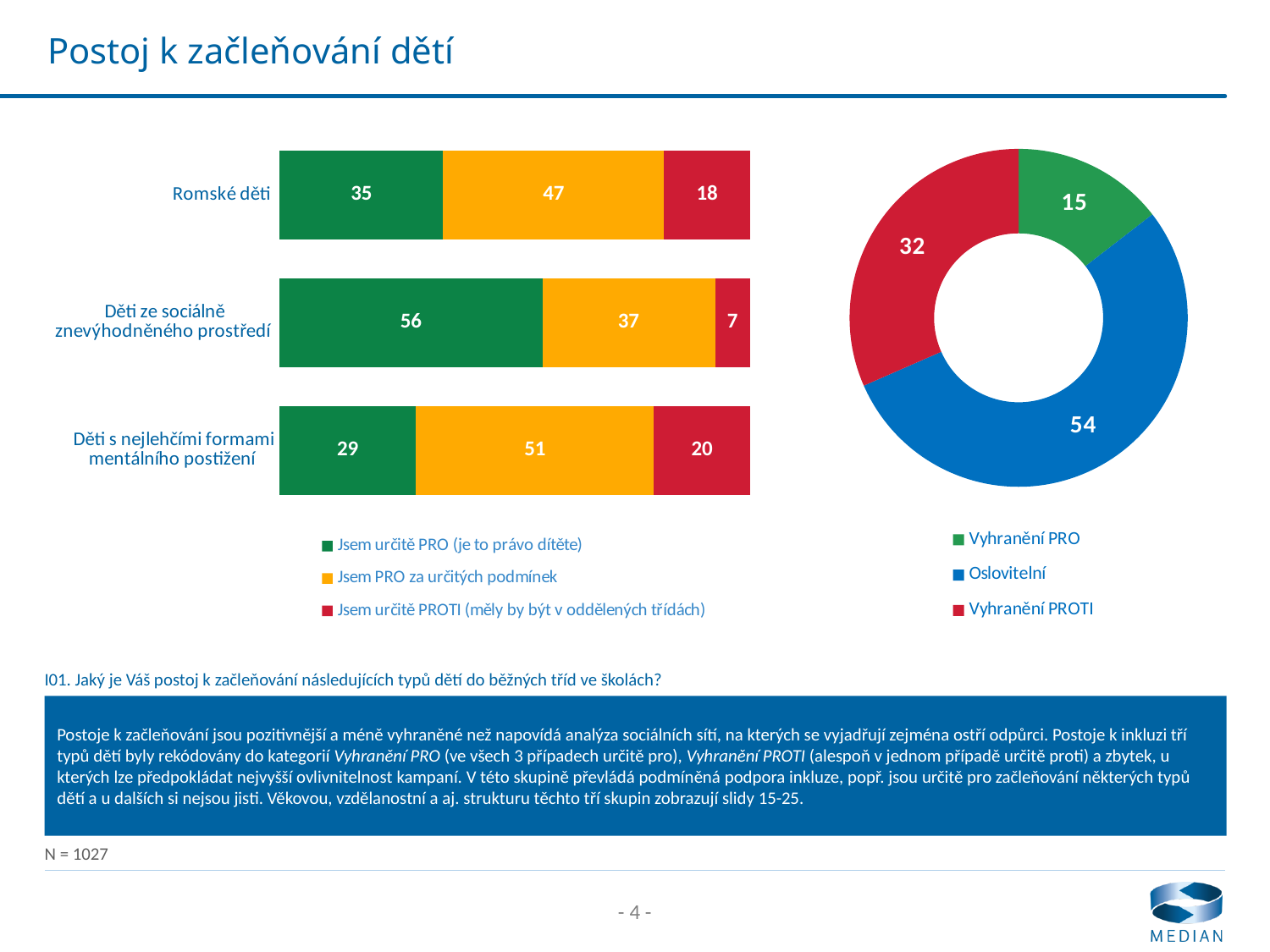
In the stacked bar chart on the left, what is the value of "Jsem určitě PROTI (měly by být v oddělených třídách)" for Děti ze sociálně znevýhodněného prostředí? 7 In the stacked bar chart on the left, which is larger: the "Jsem určitě PROTI" value for Romské děti or for Děti s nejlehčími formami mentálního postižení? Děti s nejlehčími formami mentálního postižení How many categories are shown in the stacked bar chart on the left? 3 In the stacked bar chart on the left, what is the value of "Jsem PRO za určitých podmínek" for Děti s nejlehčími formami mentálního postižení? 51 In the stacked bar chart on the left, which category has the highest value for "Jsem určitě PRO (je to právo dítěte)"? Děti ze sociálně znevýhodněného prostředí How many series does the legend of the stacked bar chart on the left list? 3 In the stacked bar chart on the left, which category has the lowest value for "Jsem určitě PROTI (měly by být v oddělených třídách)"? Děti ze sociálně znevýhodněného prostředí In the doughnut chart on the right, which segment is the smallest? Vyhranění PRO In the doughnut chart on the right, what is the value for Oslovitelní? 54 In the stacked bar chart on the left, what is the value of "Jsem určitě PRO (je to právo dítěte)" for Romské děti? 35 In the stacked bar chart on the left, what is the difference between the "Jsem určitě PRO" values for Děti ze sociálně znevýhodněného prostředí and Romské děti? 21 What type of chart is shown on the right side of the slide? Doughnut chart